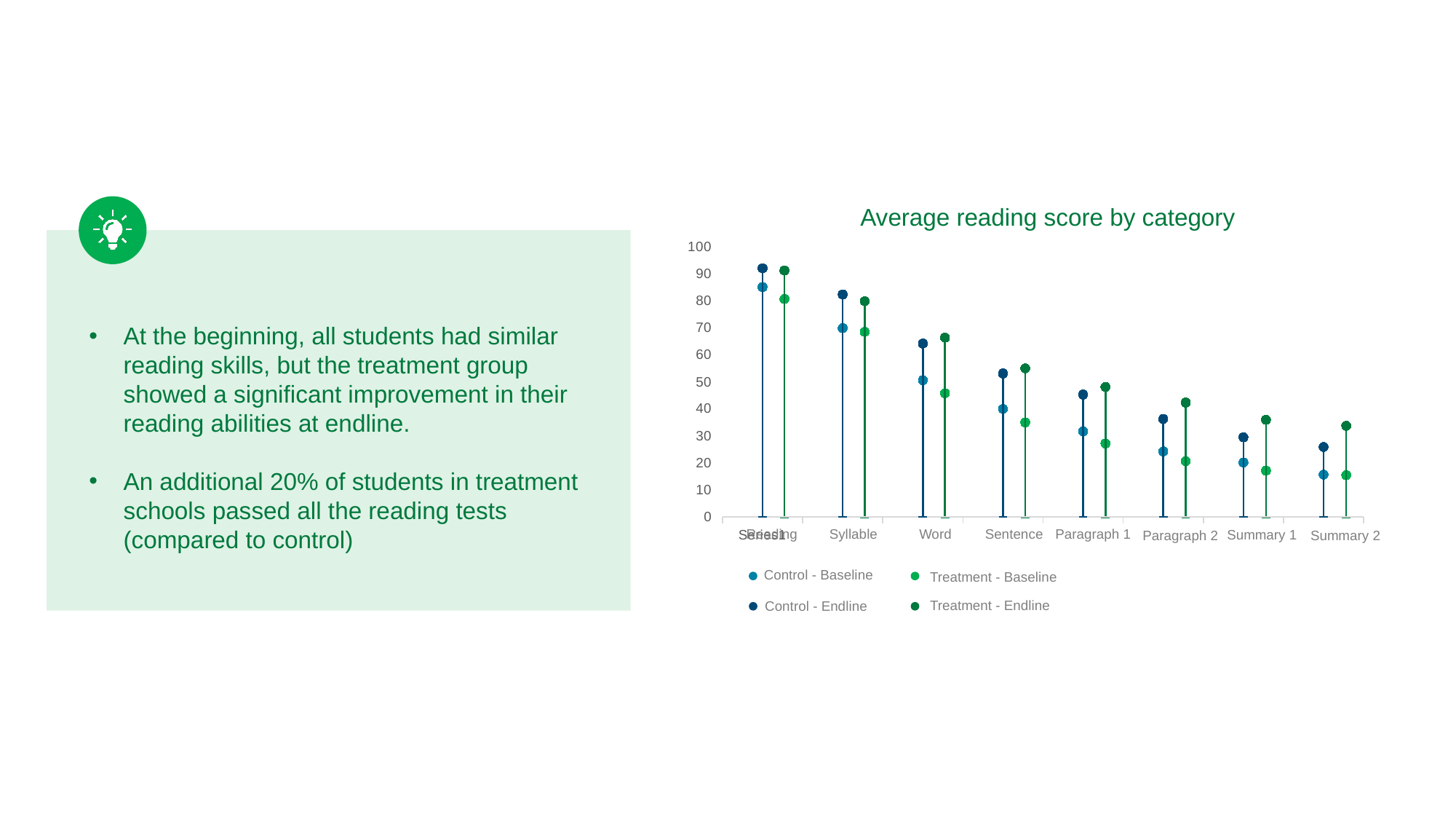
How many series does the legend of the 'Average reading score by category' chart list? 4 Is the Treatment - Endline value for Syllable greater or less than 70? greater Which category has the highest Treatment - Endline value? Reading For Paragraph 2, which is larger: the Treatment - Endline value or the Control - Endline value? Treatment - Endline Is the Treatment - Baseline value for Summary 2 greater or less than 20? less What is the title of the chart on the slide? Average reading score by category Do the Control - Baseline values rise or fall moving from Reading to Summary 2 along the x axis? fall How many categories are shown on the x axis of the 'Average reading score by category' chart? 8 Which series is shown in dark green in the chart's legend? Treatment - Endline For Summary 1, which is larger: the Treatment - Endline value or the Control - Endline value? Treatment - Endline Is the Control - Endline value for Paragraph 1 greater or less than 40? greater Which category has the lowest Control - Baseline value? Summary 2